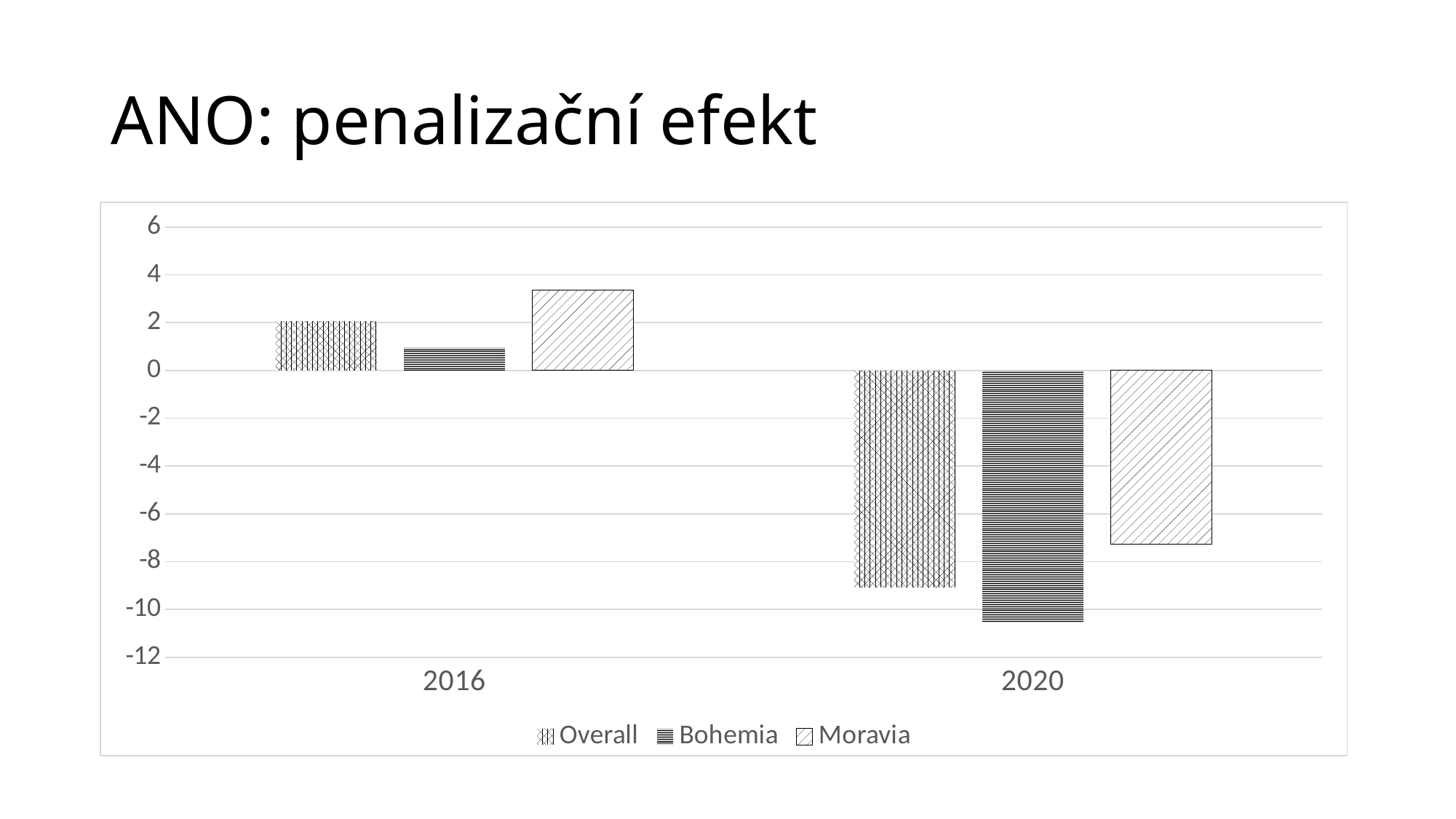
What kind of chart is shown on the slide? bar chart Which series has the highest value in 2016? Moravia Is the value for Moravia in 2020 greater or less than -8? greater How many categories are shown on the x axis? 2 Which series has the lowest value in 2020? Bohemia Do the values for Overall rise or fall from 2016 to 2020? fall What is the title of the slide? ANO: penalizační efekt Is the value for Bohemia in 2016 greater or less than 2? less Which is larger in 2016, the value for Moravia or the value for Bohemia? Moravia How many series does the legend list? 3 Is the value for Moravia in 2016 greater or less than 2? greater